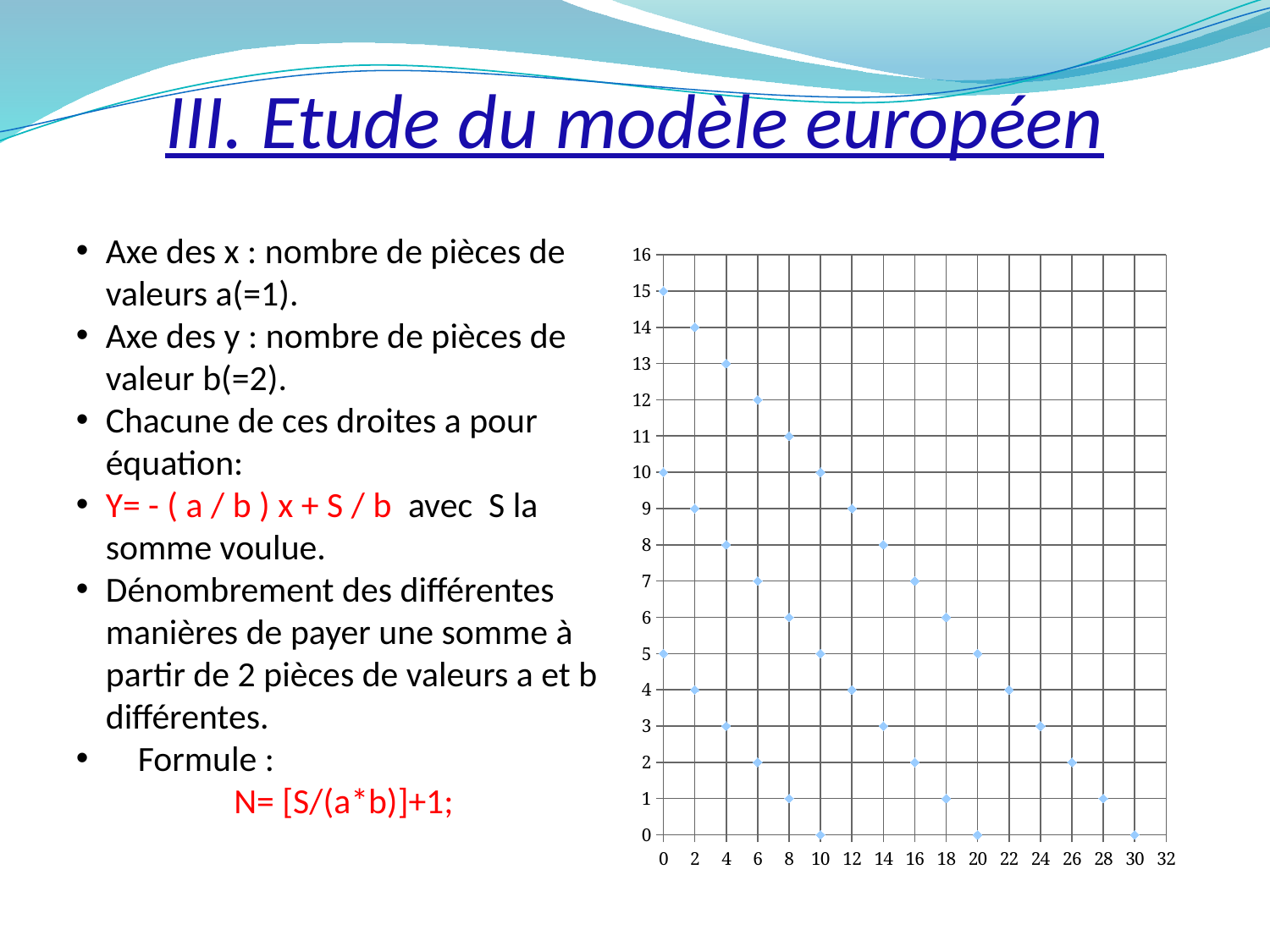
Is the y value of the highest point at x = 4 greater or less than 10? greater What is the y value of the point at x = 8 on the lowest line of points? 1 At what x value does the middle line of points reach y = 0? 20 What is the maximum value shown on the x axis? 32 What kind of chart is shown on the right of the slide? scatter chart Along each line of points in the chart, do the y values rise or fall as x increases? fall How many points make up the lowest line of points (from x = 0 to x = 10)? 6 What is the difference between the y values of the highest and lowest points at x = 0? 10 What is the highest y value reached by any point in the chart? 15 What is the largest x value at which a point lies on the x axis (y = 0)? 30 What is the y value of the highest point at x = 0? 15 How many separate lines of points are plotted in the chart? 3